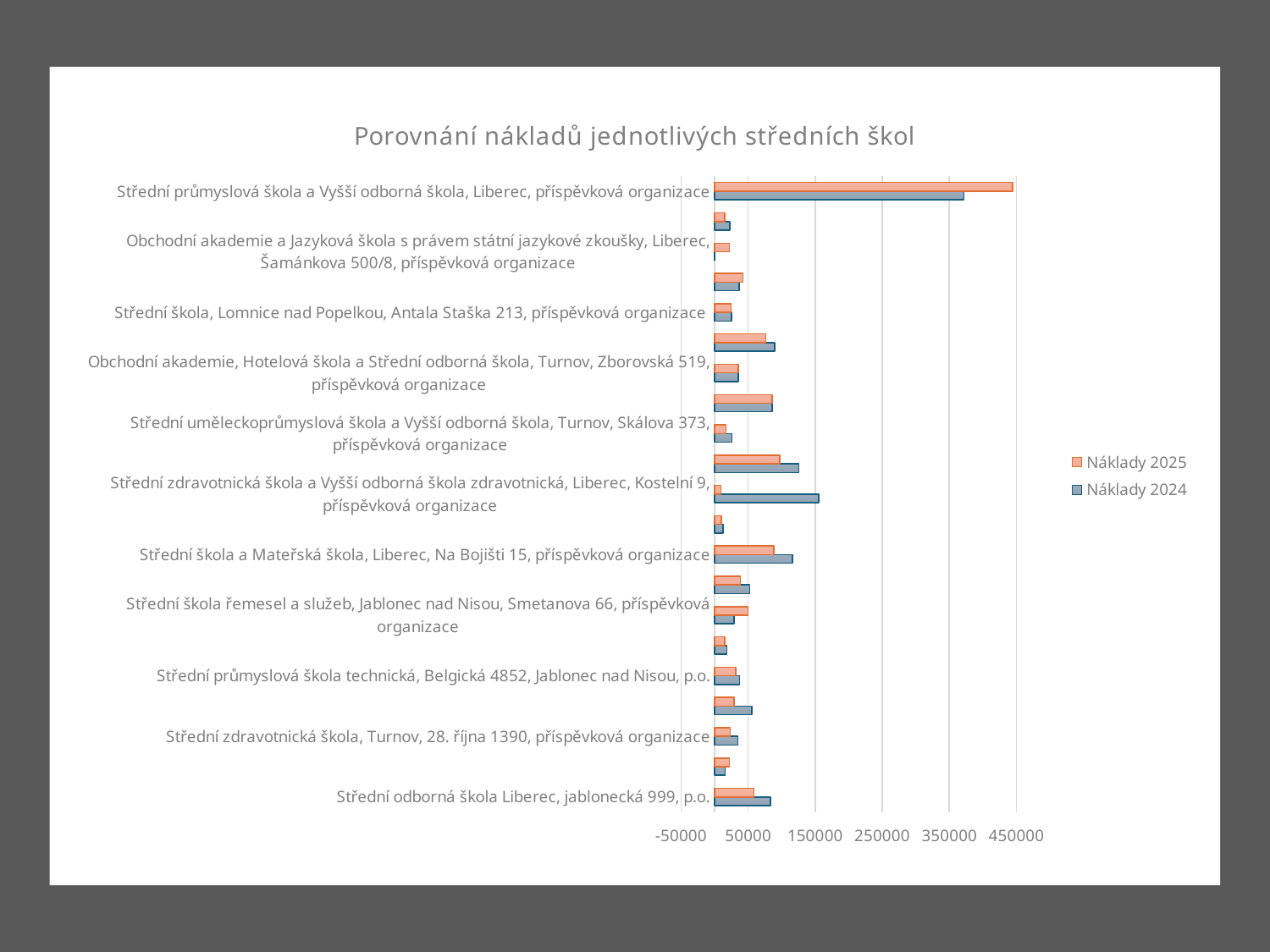
Is the Náklady 2024 value for Střední průmyslová škola a Vyšší odborná škola, Liberec, příspěvková organizace greater or less than 250000? greater What is the title of the chart? Porovnání nákladů jednotlivých středních škol Which series is shown in orange in the legend? Náklady 2025 What kind of chart is shown on the slide? bar chart Is the Náklady 2024 value for Střední odborná škola Liberec, jablonecká 999, p.o. greater or less than 50000? greater Which school has the highest Náklady 2025 value? Střední průmyslová škola a Vyšší odborná škola, Liberec, příspěvková organizace Is the Náklady 2025 value for Střední odborná škola Liberec, jablonecká 999, p.o. greater or less than 150000? less For Střední odborná škola Liberec, jablonecká 999, p.o., which is larger: Náklady 2025 or Náklady 2024? Náklady 2024 For Střední průmyslová škola a Vyšší odborná škola, Liberec, příspěvková organizace, which is larger: Náklady 2025 or Náklady 2024? Náklady 2025 How many series does the legend list? 2